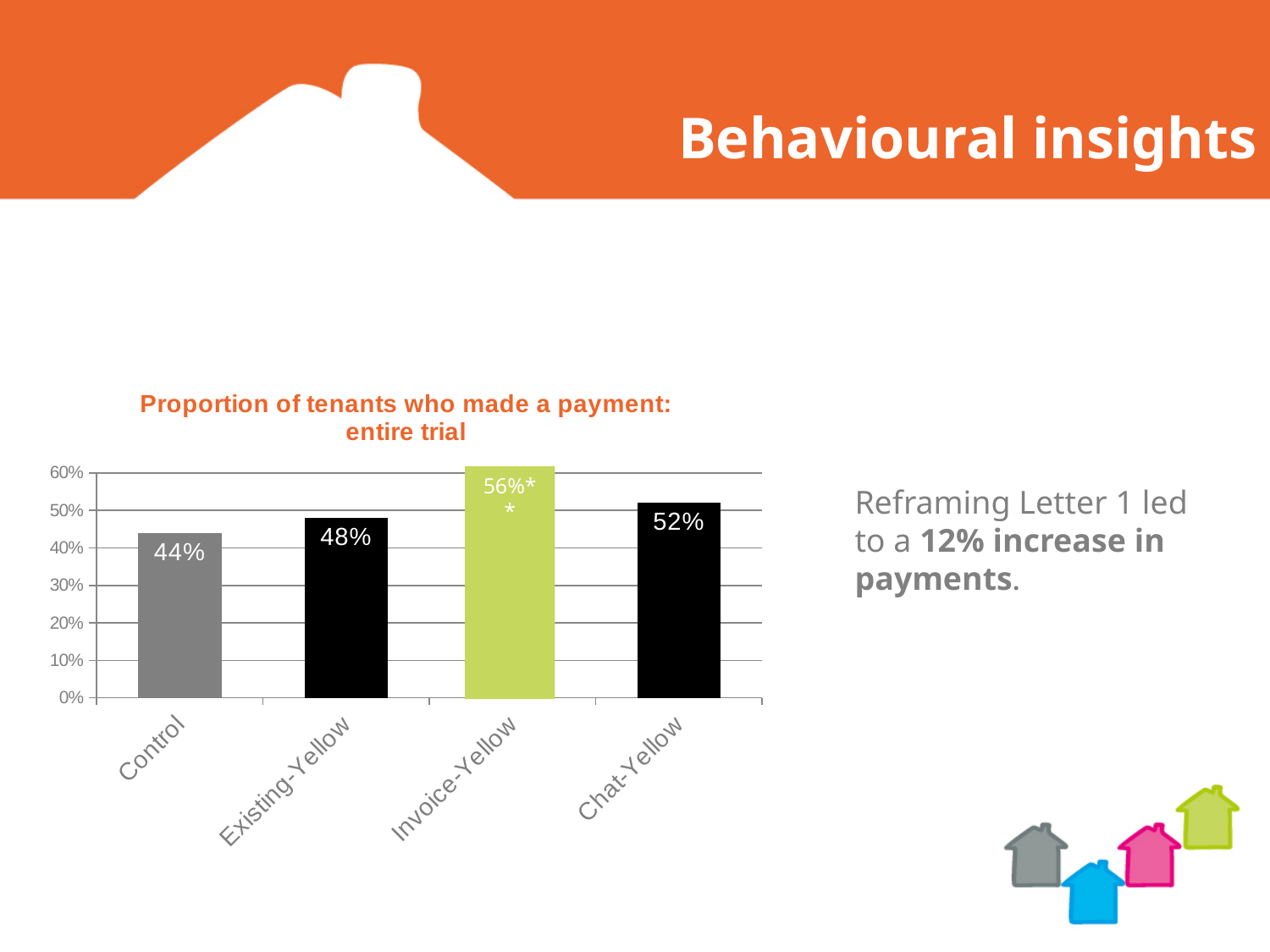
What is the value for Chat-Yellow? 52% Which is larger, the value for Chat-Yellow or the value for Existing-Yellow? Chat-Yellow Which category has the lowest proportion of tenants who made a payment? Control What is the value for Existing-Yellow? 48% What is the value for Control? 44% Which category has the highest proportion of tenants who made a payment? Invoice-Yellow What is the value for Invoice-Yellow? 56% What is the difference between the values for Invoice-Yellow and Control? 12% What kind of chart is shown on the slide? bar chart How many categories are shown on the x axis? 4 Is the value for Control greater or less than 50%? less What is the title of the chart? Proportion of tenants who made a payment: entire trial